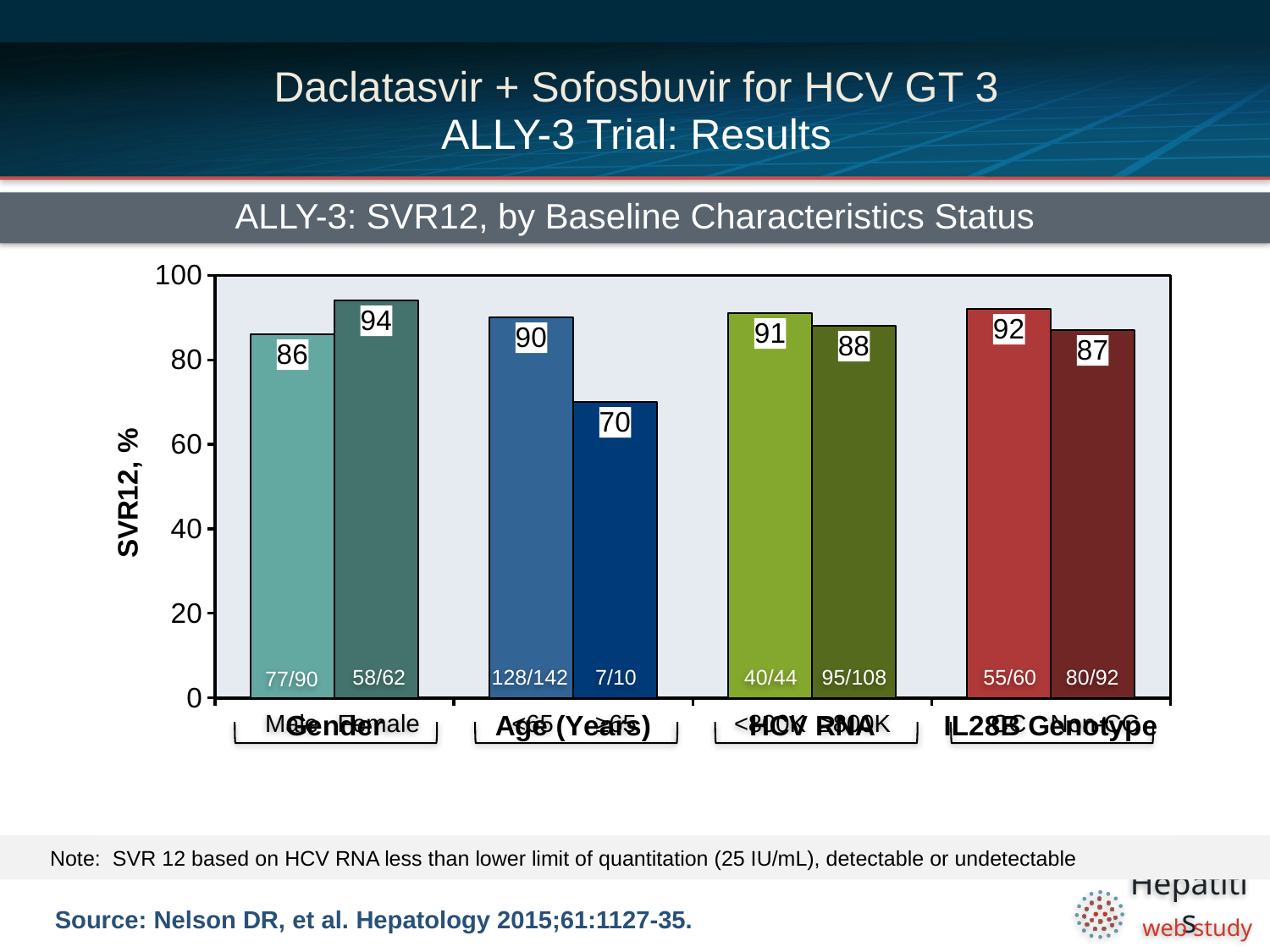
What is the SVR12 value for Male patients in the Gender group? 86 What is the SVR12 value for Female patients in the Gender group? 94 How many bars are plotted on the chart? 8 What is the difference in SVR12 between Female and Male patients? 8 What is the label of the y axis? SVR12, % Which bar has the highest SVR12 value on the chart? Female (94) What is the SVR12 value for the second bar in the IL28B Genotype group? 87 What is the SVR12 value for the first bar (<65) in the Age (Years) group? 90 What is the SVR12 value for the first bar in the HCV RNA group? 91 Which bar has the lowest SVR12 value on the chart? ≥65 in the Age (Years) group (70) What type of chart is shown on the slide? bar chart What is the SVR12 value for the second bar (≥65) in the Age (Years) group? 70